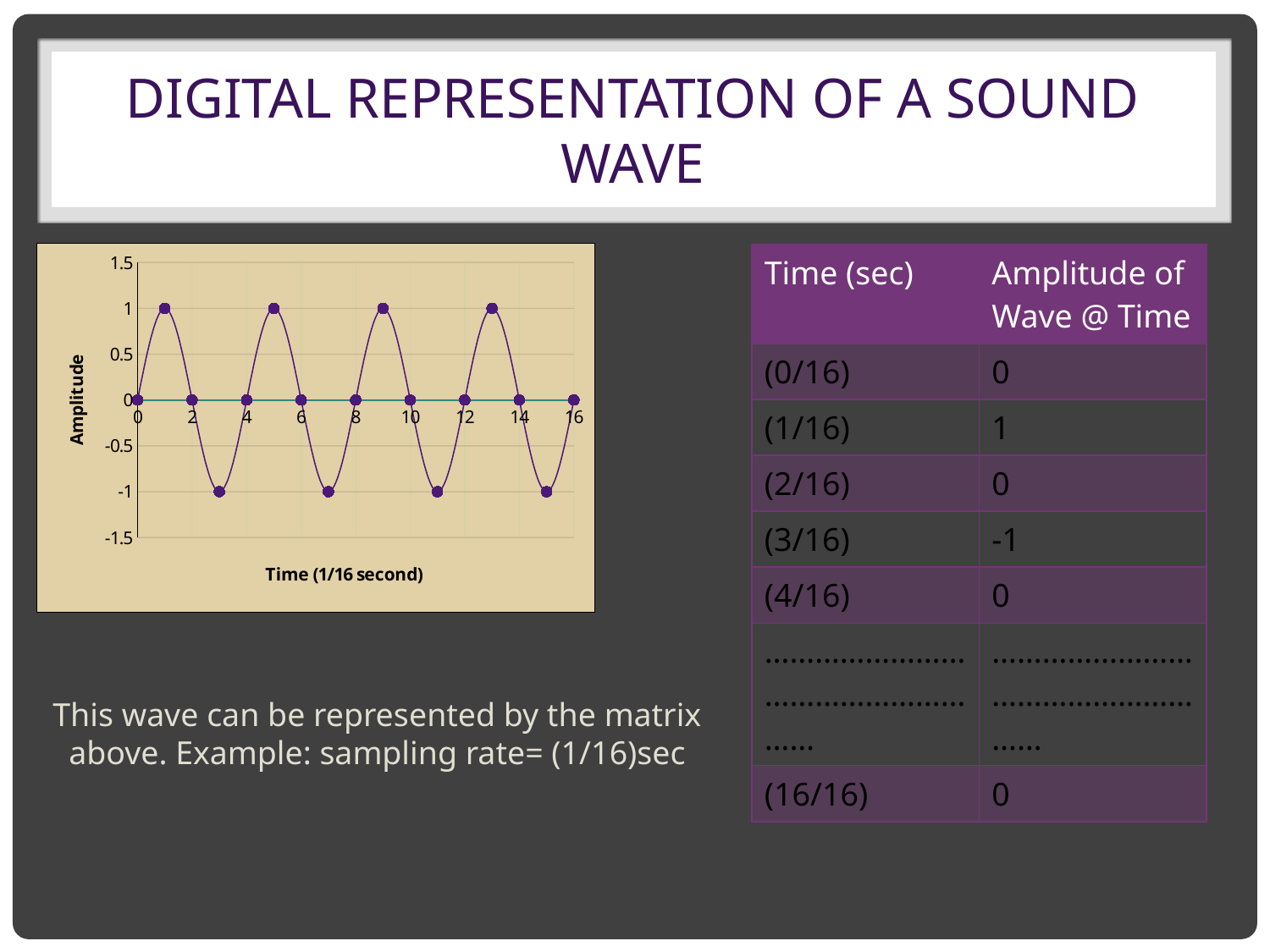
What is the title of the y axis of the chart? Amplitude What is the amplitude at time 1 on the chart? 1 What kind of chart is shown on the slide? line chart What is the title of the x axis of the chart? Time (1/16 second) What is the amplitude at time 16 on the chart? 0 How many data points are plotted on the chart? 17 What is the amplitude at time 3 on the chart? -1 Which is larger, the amplitude at time 5 or the amplitude at time 7? time 5 What is the highest amplitude value reached by the wave on the chart? 1 What is the amplitude at time 2 on the chart? 0 What is the lowest amplitude value reached by the wave on the chart? -1 What is the difference between the amplitude at time 1 and the amplitude at time 3? 2